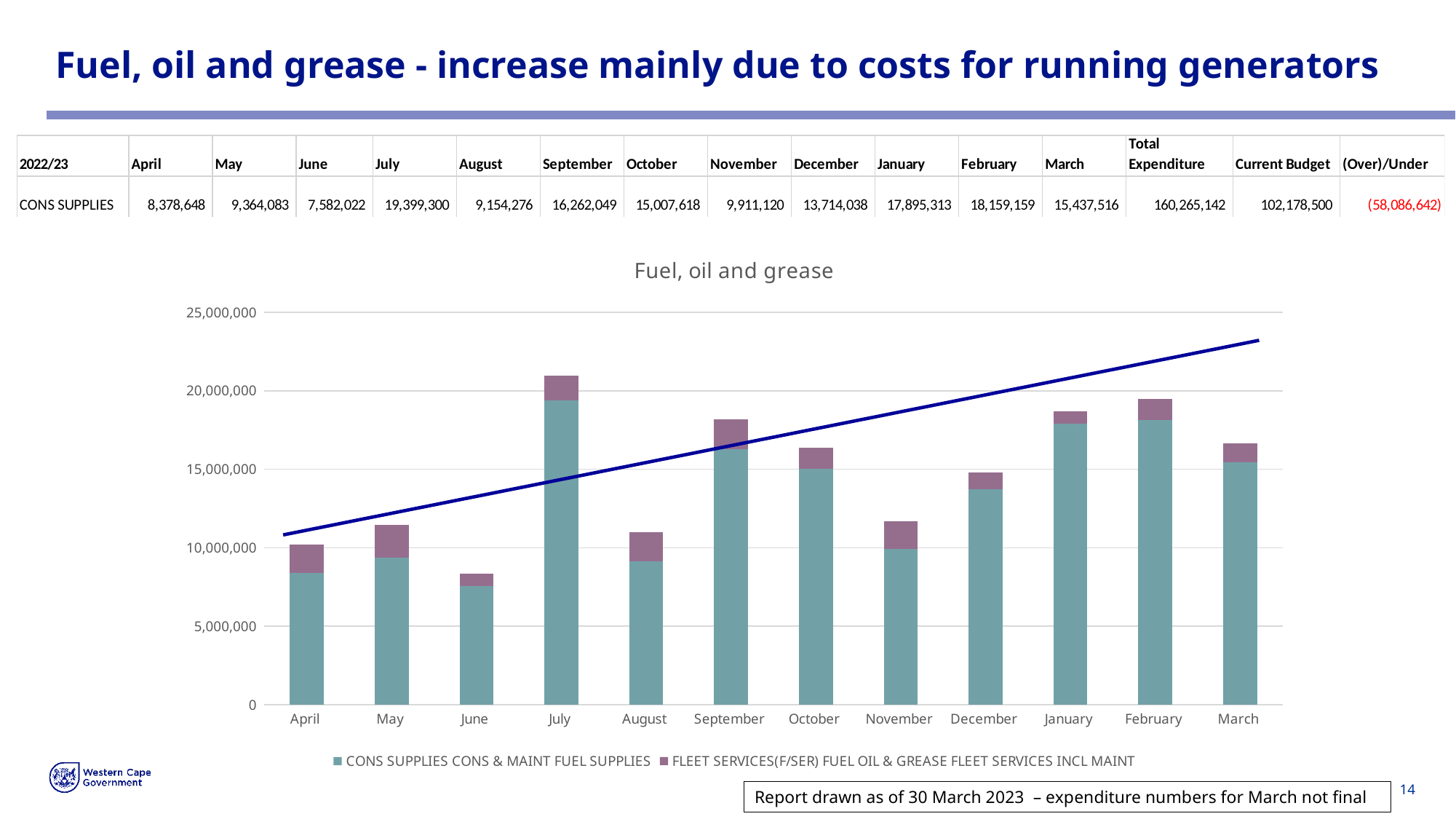
What kind of chart is shown on the slide? Stacked bar chart How many months are shown on the x axis of the chart? 12 Is the total bar for July greater or less than 20,000,000? greater How many series does the chart legend list? 2 According to the table, what is the CONS SUPPLIES expenditure for July? 19,399,300 Which month has the lowest total bar in the chart? June Is the total bar for November greater or less than 15,000,000? less Which month has the highest total bar in the chart? July Does the trend line drawn across the chart rise or fall from April to March? Rises What is the title of the chart? Fuel, oil and grease Which month has the larger total bar, July or September? July Is the total bar for June greater or less than 10,000,000? less